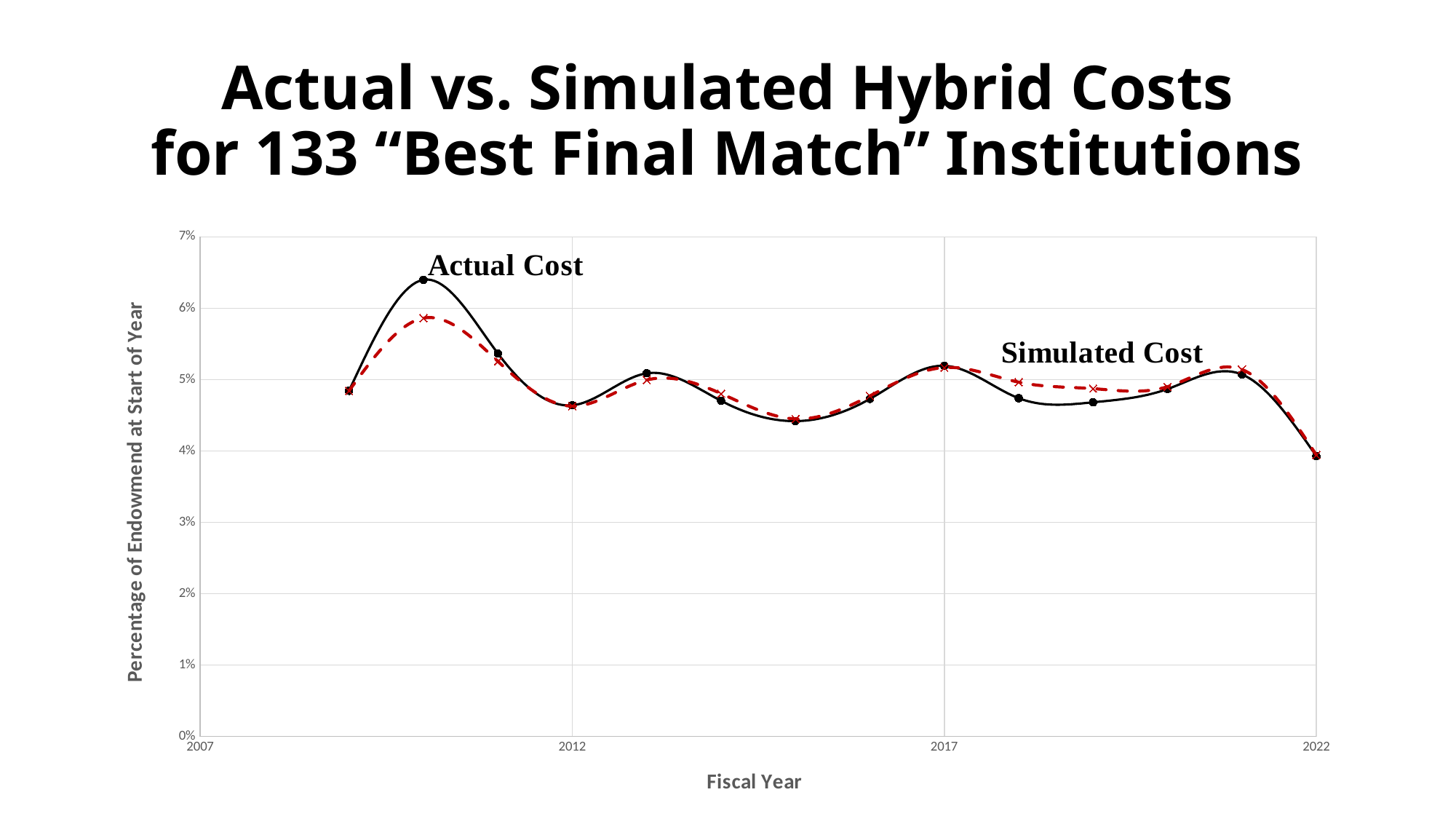
What are the names of the two series plotted on the chart? Actual Cost and Simulated Cost How many data points are plotted for the Actual Cost series? 14 What is the label of the x axis? Fiscal Year At the peak around 2010, which series has the higher value, Actual Cost or Simulated Cost? Actual Cost Is the highest value of the Actual Cost series greater or less than 6%? greater Is the Actual Cost value for fiscal year 2012 greater or less than 5%? less Is the Actual Cost value for fiscal year 2017 greater or less than 5%? greater How many series are plotted on the chart? 2 Do the Actual Cost values rise or fall between fiscal year 2017 and fiscal year 2022? Fall In which fiscal year does the Actual Cost series reach its lowest value? 2022 What kind of chart is shown on the slide? Line chart